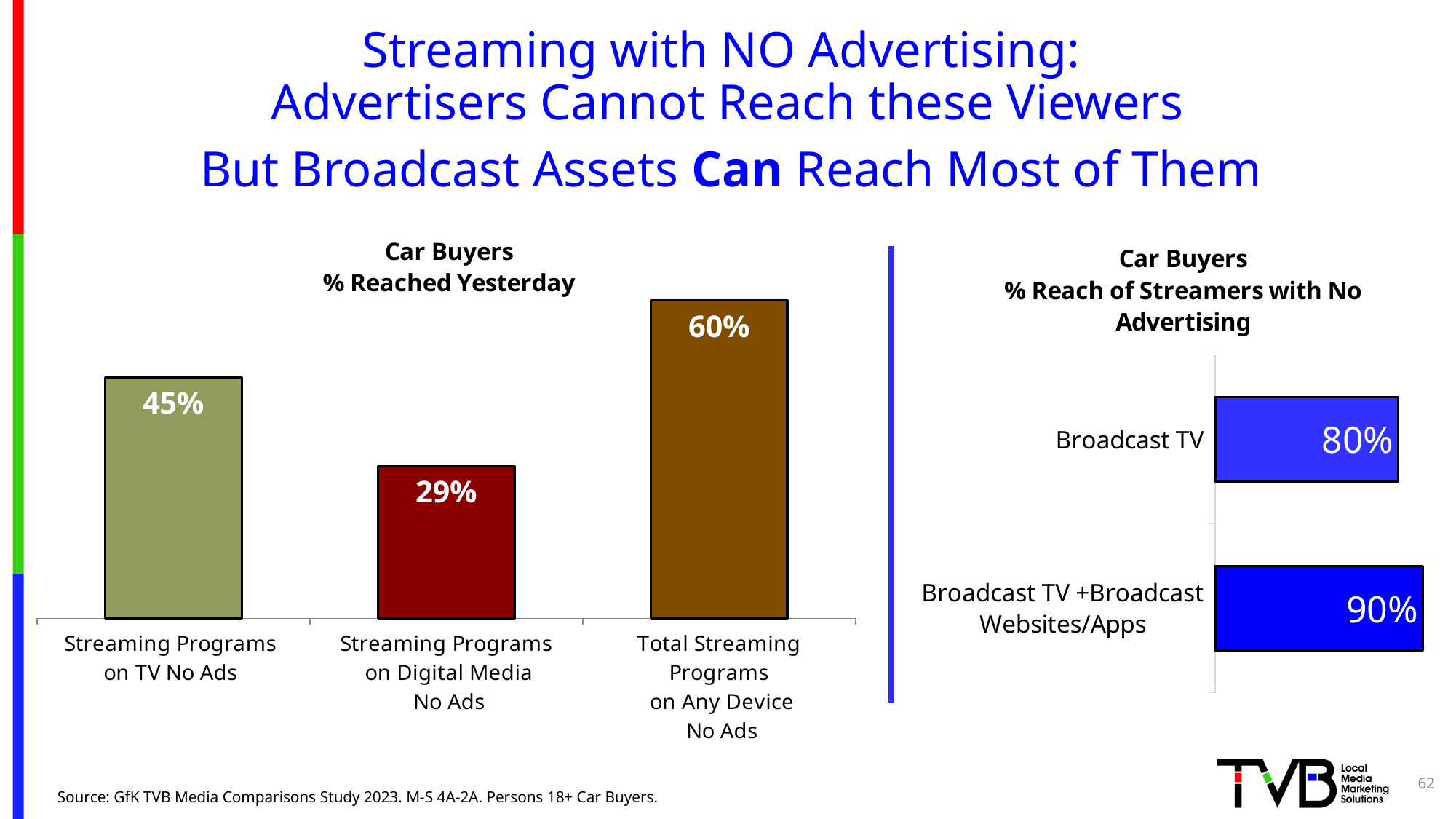
In the left chart (Car Buyers % Reached Yesterday), what is the value for Streaming Programs on TV No Ads? 45% In the right chart (% Reach of Streamers with No Advertising), which is larger: Broadcast TV or Broadcast TV + Broadcast Websites/Apps? Broadcast TV + Broadcast Websites/Apps In the left chart (Car Buyers % Reached Yesterday), which category has the highest value? Total Streaming Programs on Any Device No Ads In the right chart (% Reach of Streamers with No Advertising), what is the difference between Broadcast TV + Broadcast Websites/Apps and Broadcast TV? 10 percentage points In the right chart (% Reach of Streamers with No Advertising), what is the value for Broadcast TV + Broadcast Websites/Apps? 90% In the right chart (% Reach of Streamers with No Advertising), what is the value for Broadcast TV? 80% In the left chart (Car Buyers % Reached Yesterday), what is the difference between Total Streaming Programs on Any Device No Ads and Streaming Programs on TV No Ads? 15 percentage points In the left chart (Car Buyers % Reached Yesterday), which category has the lowest value? Streaming Programs on Digital Media No Ads In the right chart (% Reach of Streamers with No Advertising), how many categories are shown? 2 In the left chart (Car Buyers % Reached Yesterday), how many categories are shown? 3 What type of chart is the left chart (Car Buyers % Reached Yesterday)? Bar chart In the left chart (Car Buyers % Reached Yesterday), what is the value for Streaming Programs on Digital Media No Ads? 29%